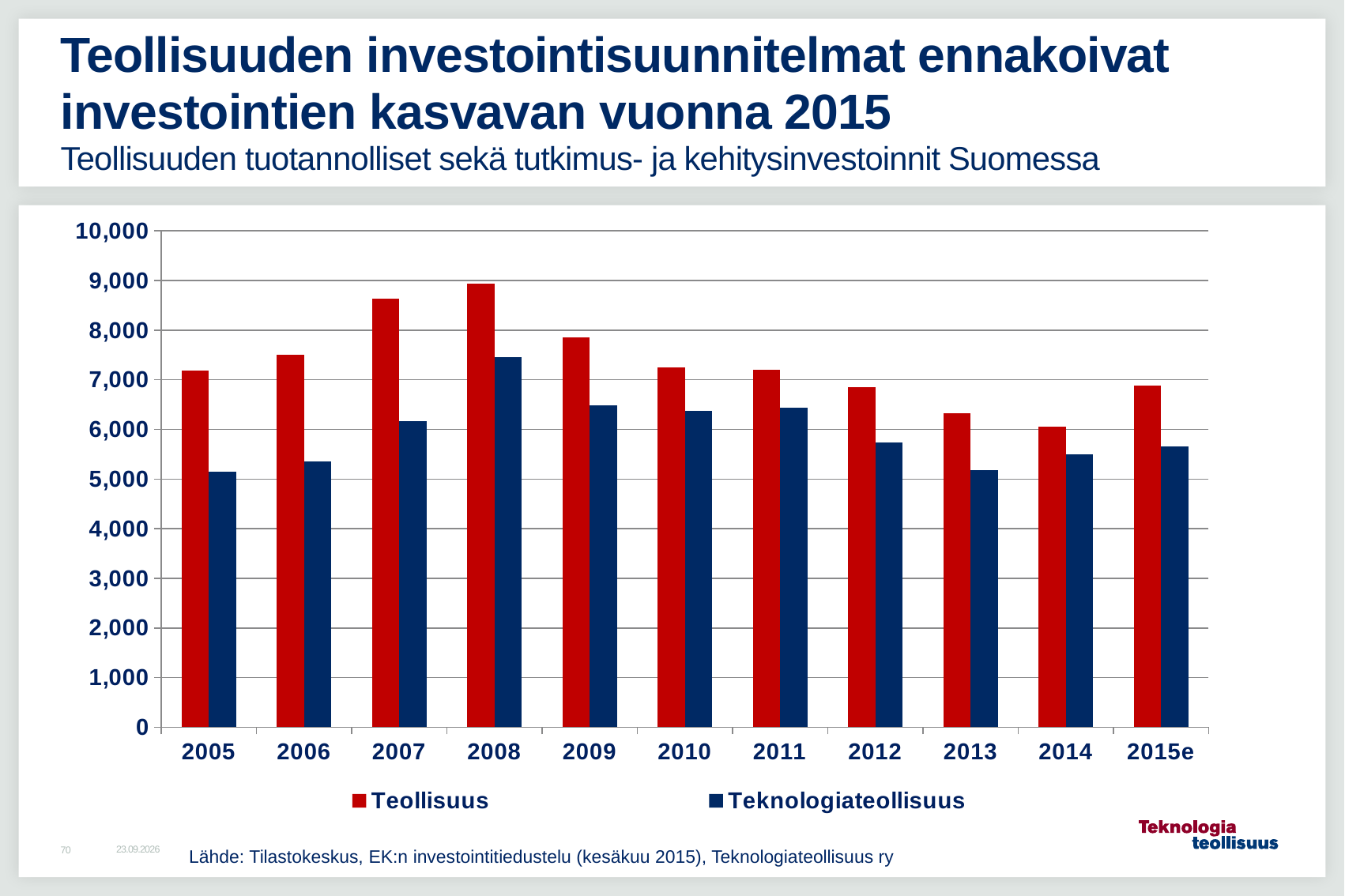
Does the Teollisuus value rise or fall from 2008 to 2014? fall How many years are shown on the x axis? 11 What kind of chart is shown on the slide? bar chart In which year is the Teknologiateollisuus value highest? 2008 Which colour represents the Teknologiateollisuus series? dark blue How many series does the legend list? 2 Is the Teknologiateollisuus value for 2012 greater or less than 6,000? less Is the Teollisuus value for 2008 greater or less than 8,000? greater Is the Teknologiateollisuus value for 2008 greater or less than 7,000? greater In which year is the Teollisuus value lowest? 2014 In which year is the Teollisuus value highest? 2008 Which is larger, the Teollisuus value for 2007 or for 2009? 2007